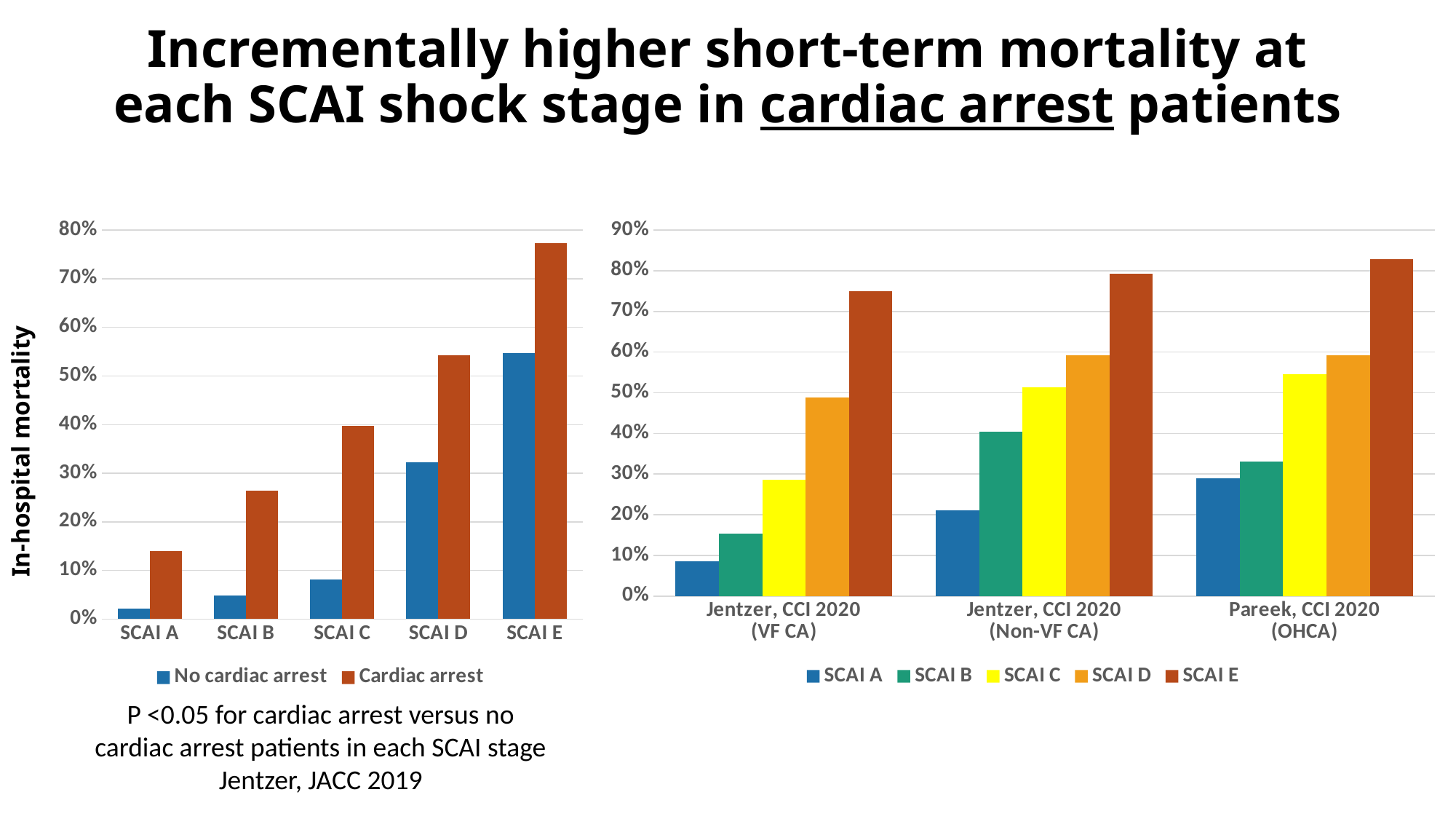
On the right chart, how many study groups are shown on the x axis? 3 On the left chart, is the No cardiac arrest value for SCAI D greater or less than 30%? greater On the left chart, how many SCAI stage categories are shown on the x axis? 5 On the right chart, is the SCAI A value for Jentzer, CCI 2020 (VF CA) greater or less than 10%? less On the left chart, is the Cardiac arrest value for SCAI E greater or less than 70%? greater What kind of chart is the left chart? Bar chart On the left chart, do the Cardiac arrest values rise or fall from SCAI A to SCAI E? rise On the right chart, how many series does the legend list? 5 On the left chart, how many series does the legend list? 2 On the left chart, which SCAI stage has the highest Cardiac arrest mortality? SCAI E On the left chart, which SCAI stage has the lowest No cardiac arrest mortality? SCAI A On the right chart, which study group has the highest SCAI E mortality? Pareek, CCI 2020 (OHCA)